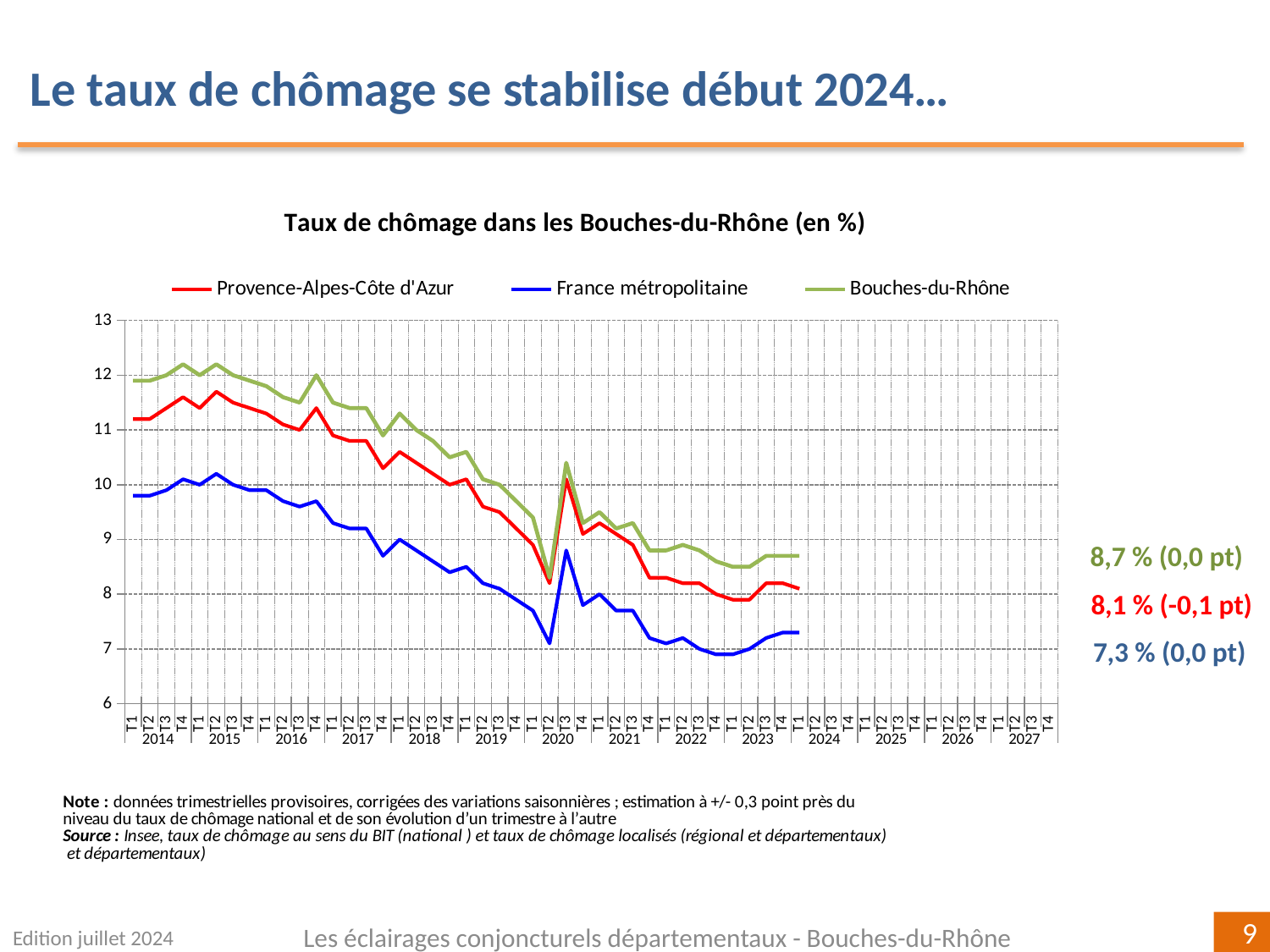
Do the values for Bouches-du-Rhône rise or fall between 2014 and 2019? fall At the latest point, which is higher: Provence-Alpes-Côte d'Azur or France métropolitaine? Provence-Alpes-Côte d'Azur What is the difference between the latest rates for Bouches-du-Rhône and France métropolitaine? 1,4 points Is the value for France métropolitaine in T1 2014 greater or less than 9? greater What kind of chart is shown on the slide? line chart What is the latest unemployment rate shown for Provence-Alpes-Côte d'Azur? 8,1 % How many series does the legend list? 3 Which series is the lowest across the whole period? France métropolitaine What is the latest unemployment rate shown for France métropolitaine? 7,3 % What is the latest unemployment rate shown for Bouches-du-Rhône? 8,7 % Which series has the highest value at the latest point? Bouches-du-Rhône What is the quarterly change shown for Provence-Alpes-Côte d'Azur at the latest point? -0,1 pt